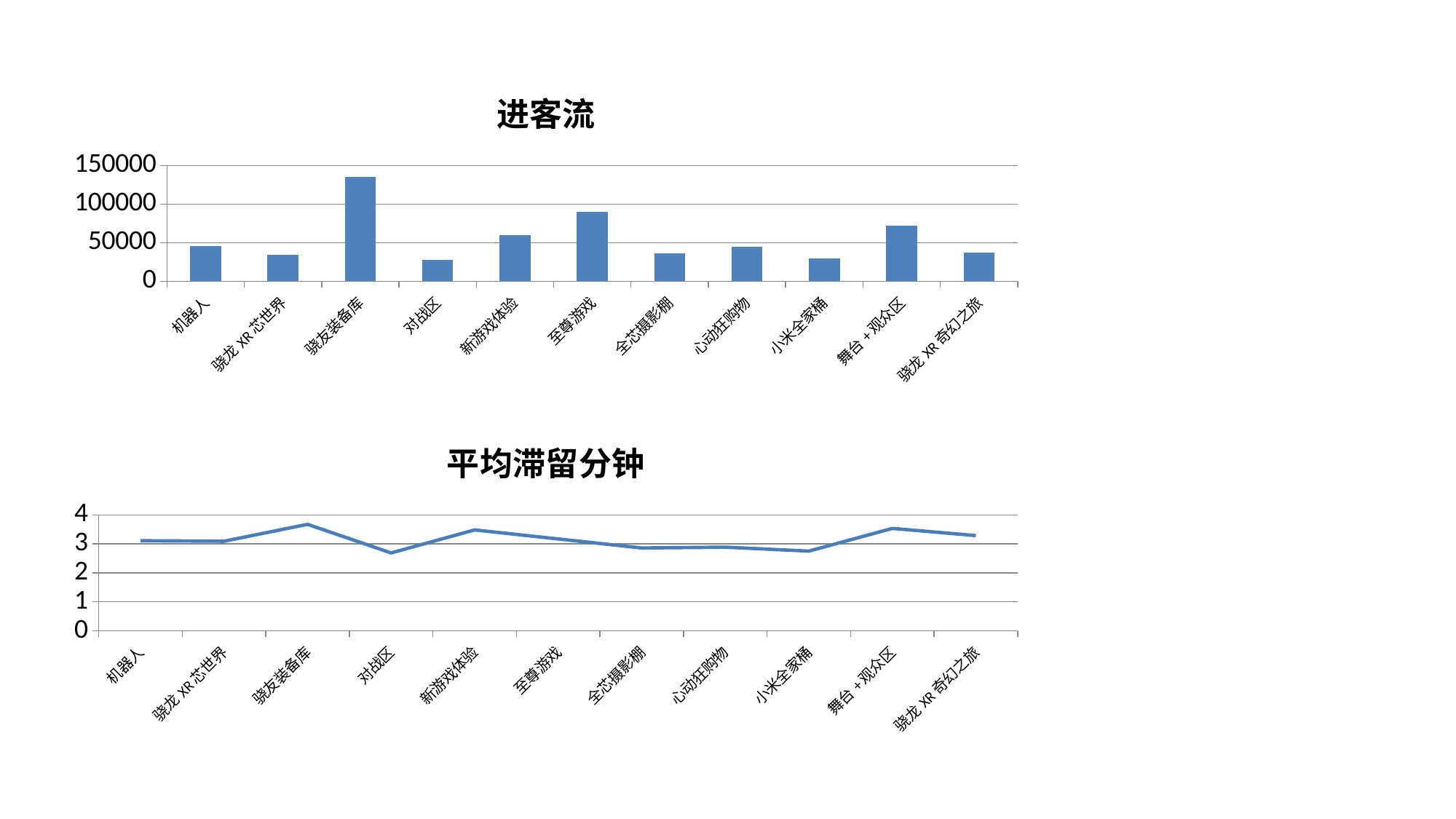
In the 平均滞留分钟 chart, is the value for 对战区 greater or less than 3? less What kind of chart is the chart titled 平均滞留分钟? line chart In the 进客流 chart, which is larger, the value for 至尊游戏 or the value for 小米全家桶? 至尊游戏 In the 平均滞留分钟 chart, which category has the highest value? 骁友装备库 In the 平均滞留分钟 chart, which category has the lowest value? 对战区 In the 进客流 chart, how many categories are shown on the x axis? 11 In the 进客流 chart, which category has the highest value? 骁友装备库 In the 进客流 chart, is the value for 骁友装备库 greater or less than 100000? greater In the 进客流 chart, is the value for 对战区 greater or less than 50000? less What kind of chart is the chart titled 进客流? bar chart In the 进客流 chart, which category has the lowest value? 对战区